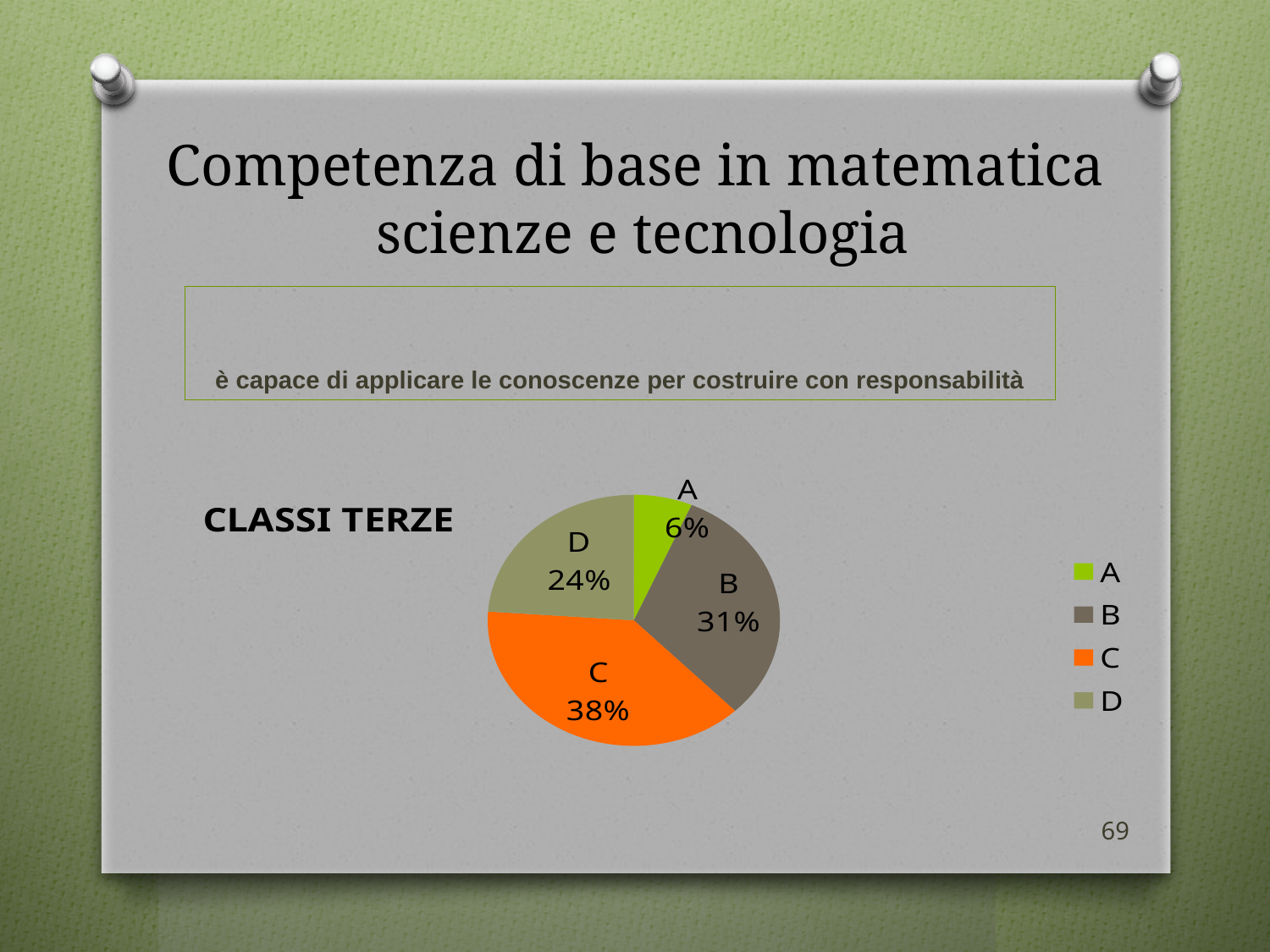
What share of the pie does slice C represent? 38% What is the value shown for slice B? 31% What kind of chart is shown on the slide? pie chart Which slice is the smallest in the pie chart? A What is the difference between the values for C and B? 7% What is the value shown for slice A? 6% What is the value shown for slice D? 24% How many slices does the pie chart have? 4 What label appears to the left of the pie chart? CLASSI TERZE Which slice is the largest in the pie chart? C What is the difference between the values for D and A? 18% Which is larger, the value for B or the value for D? B